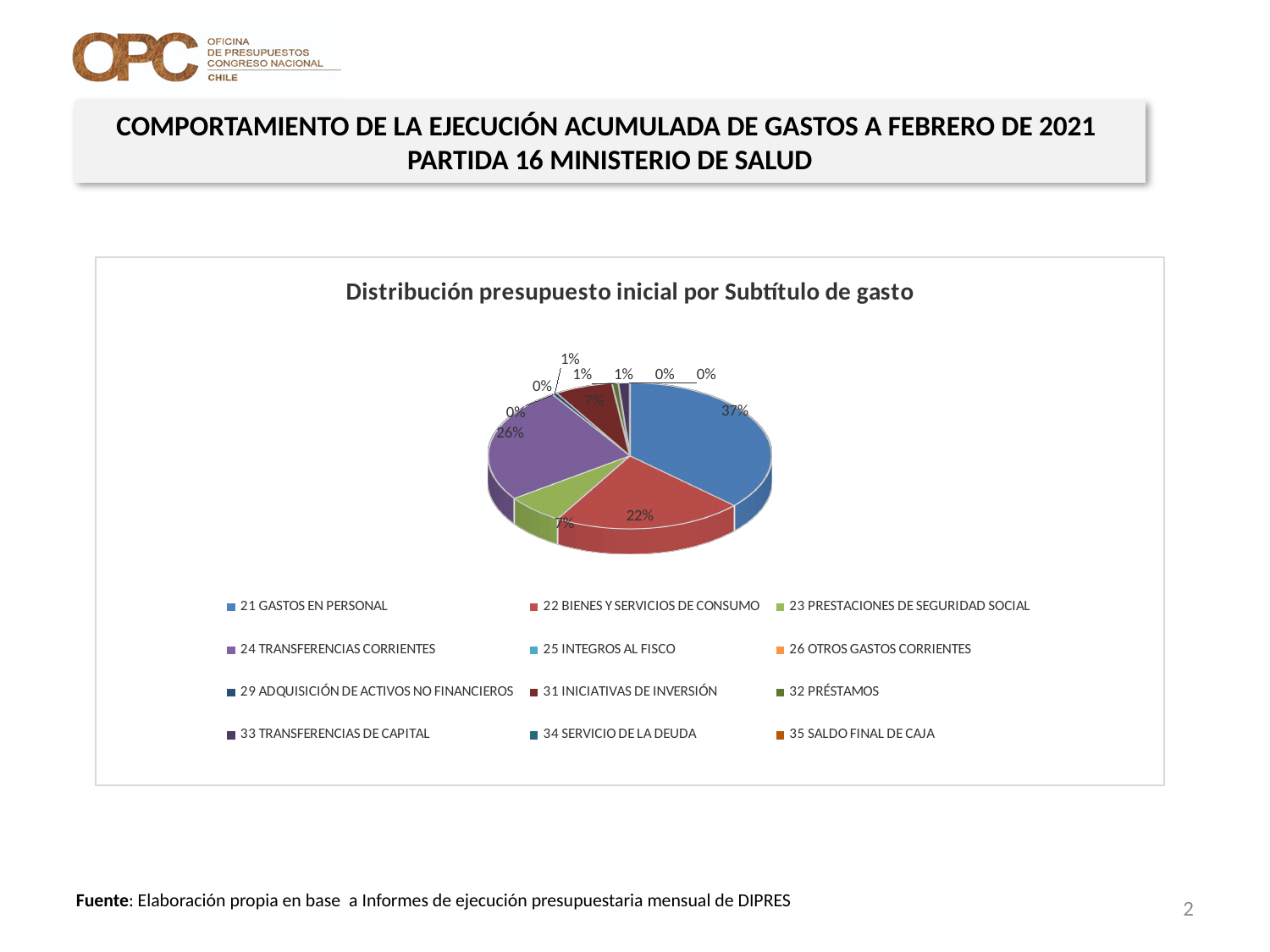
What share of the pie does 24 TRANSFERENCIAS CORRIENTES represent? 26% What is the title of the chart? Distribución presupuesto inicial por Subtítulo de gasto What share of the pie does 21 GASTOS EN PERSONAL represent? 37% What share of the pie does 23 PRESTACIONES DE SEGURIDAD SOCIAL represent? 7% How many entries does the chart legend list? 12 What colour is the slice for 21 GASTOS EN PERSONAL? blue Which is larger: the share for 22 BIENES Y SERVICIOS DE CONSUMO or for 24 TRANSFERENCIAS CORRIENTES? 24 TRANSFERENCIAS CORRIENTES What is the difference in percentage points between the share of 21 GASTOS EN PERSONAL and 22 BIENES Y SERVICIOS DE CONSUMO? 15 percentage points Which subtítulo has the largest share of the pie? 21 GASTOS EN PERSONAL What kind of chart is shown on the slide? pie chart